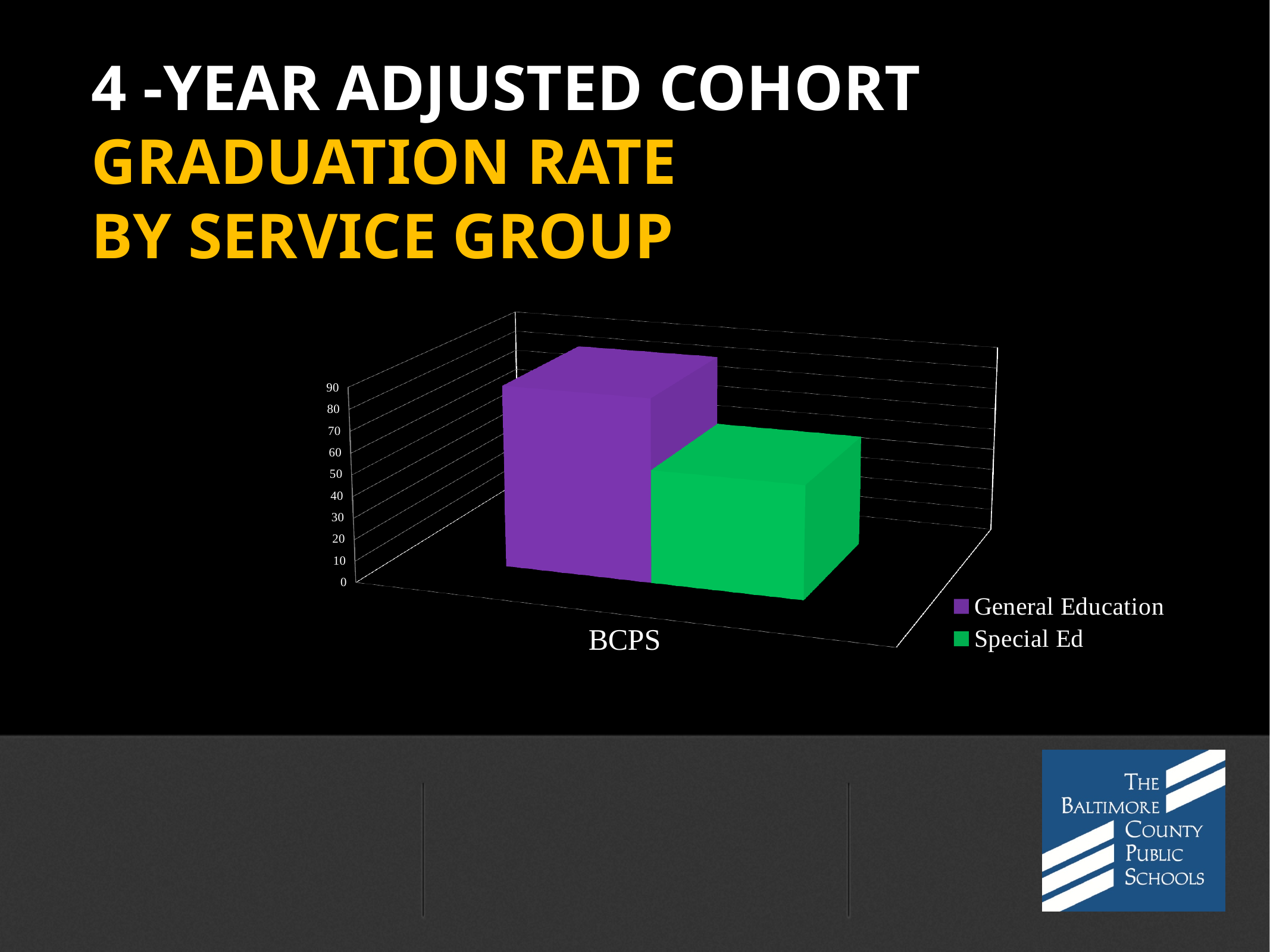
What is the highest value shown on the vertical axis? 90 Is the value for Special Ed greater or less than 30? greater Is the value for Special Ed greater or less than 90? less What colour represents the Special Ed series? green Which series has the highest bar? General Education Which series has the higher graduation rate for BCPS, General Education or Special Ed? General Education What is the category label on the x axis? BCPS How many series does the legend list? 2 Which series has the lowest bar? Special Ed What kind of chart is shown on the slide? bar chart Is the value for General Education greater or less than 50? greater How many categories are shown on the x axis? 1